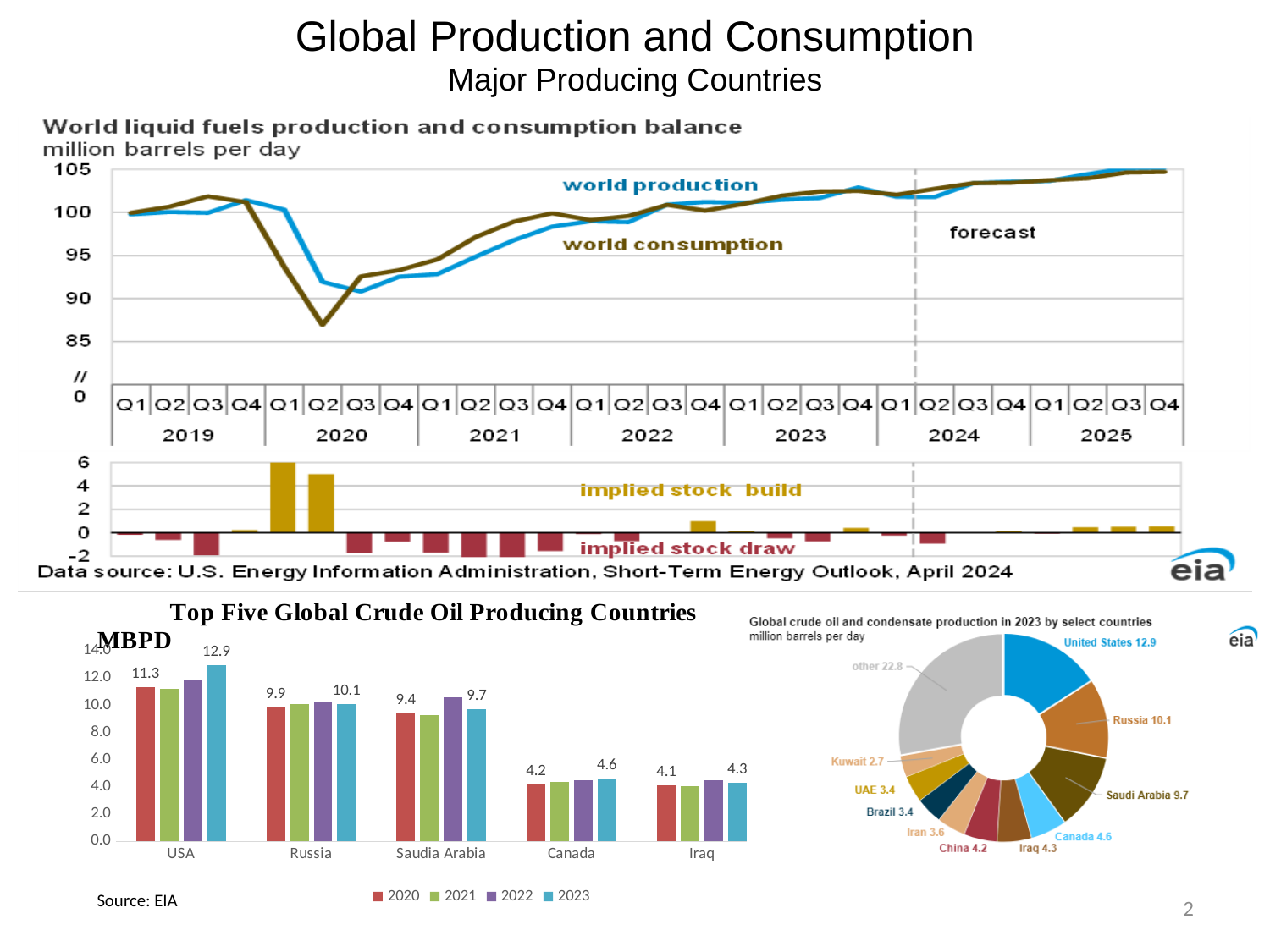
What kind of chart is the 'Global crude oil and condensate production in 2023 by select countries' chart? Donut chart In the 'Top Five Global Crude Oil Producing Countries' bar chart, what is the difference between the USA's 2023 and 2020 values? 1.6 In the 'Top Five Global Crude Oil Producing Countries' bar chart, which country has the highest 2023 value? USA In the 'Top Five Global Crude Oil Producing Countries' bar chart, what is the value for Canada in 2020? 4.2 In the 'Top Five Global Crude Oil Producing Countries' bar chart, which country has the lowest 2020 value? Iraq In the 'Global crude oil and condensate production in 2023 by select countries' chart, which is larger, Iran or Brazil? Iran In the 'World liquid fuels production and consumption balance' chart, how many lines are plotted in the upper panel? 2 In the 'Global crude oil and condensate production in 2023 by select countries' chart, what is the value for Russia? 10.1 In the 'World liquid fuels production and consumption balance' chart, is world consumption in Q2 2020 greater or less than 90? less In the 'Top Five Global Crude Oil Producing Countries' bar chart, how many countries are shown? 5 In the 'Top Five Global Crude Oil Producing Countries' bar chart, how many series does the legend list? 4 In the 'Top Five Global Crude Oil Producing Countries' bar chart, what is the value for USA in 2023? 12.9